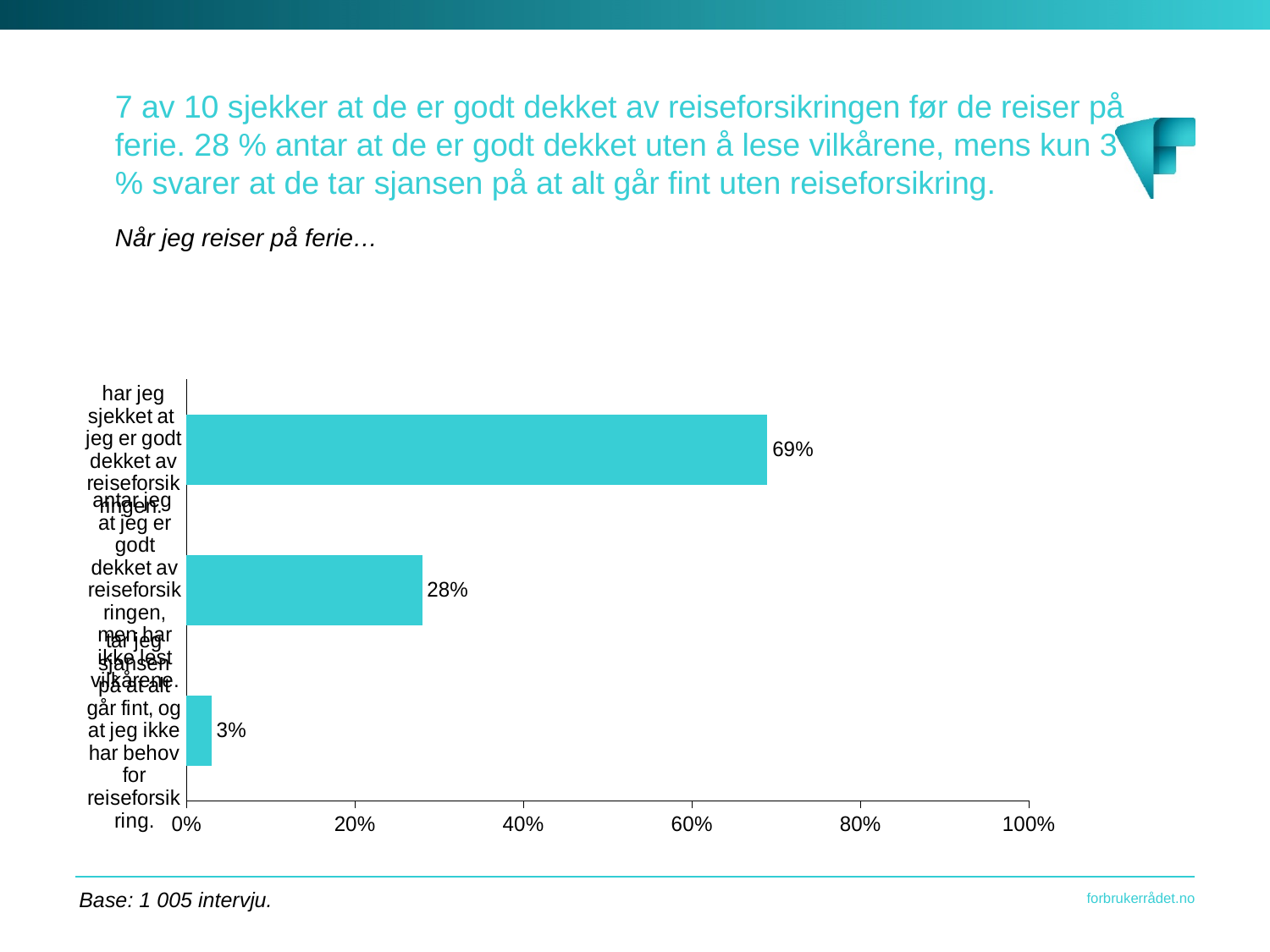
What is the maximum value shown on the horizontal axis of the chart? 100% What is the value of the bottom bar, for those who take the chance that everything goes fine without travel insurance ("tar jeg sjansen")? 3% What kind of chart is shown on the slide? bar chart Which bar has the lowest value? tar jeg sjansen på at alt går fint (bottom bar) What is the difference between the middle bar (28%) and the bottom bar (3%)? 25% Is the value of the top bar greater or less than 60%? greater What is the value of the middle bar, for those who assume they are well covered but have not read the terms ("antar jeg at jeg er godt dekket")? 28% Which bar has the highest value? har jeg sjekket at jeg er godt dekket av reiseforsikringen (top bar) What is the value of the top bar, for those who have checked that they are well covered by their travel insurance ("har jeg sjekket at jeg er godt dekket")? 69% How many bars (categories) does the chart show? 3 What is the difference between the top bar (69%) and the middle bar (28%)? 41% Which is larger: the value for the middle bar or the value for the bottom bar? the middle bar (28%)